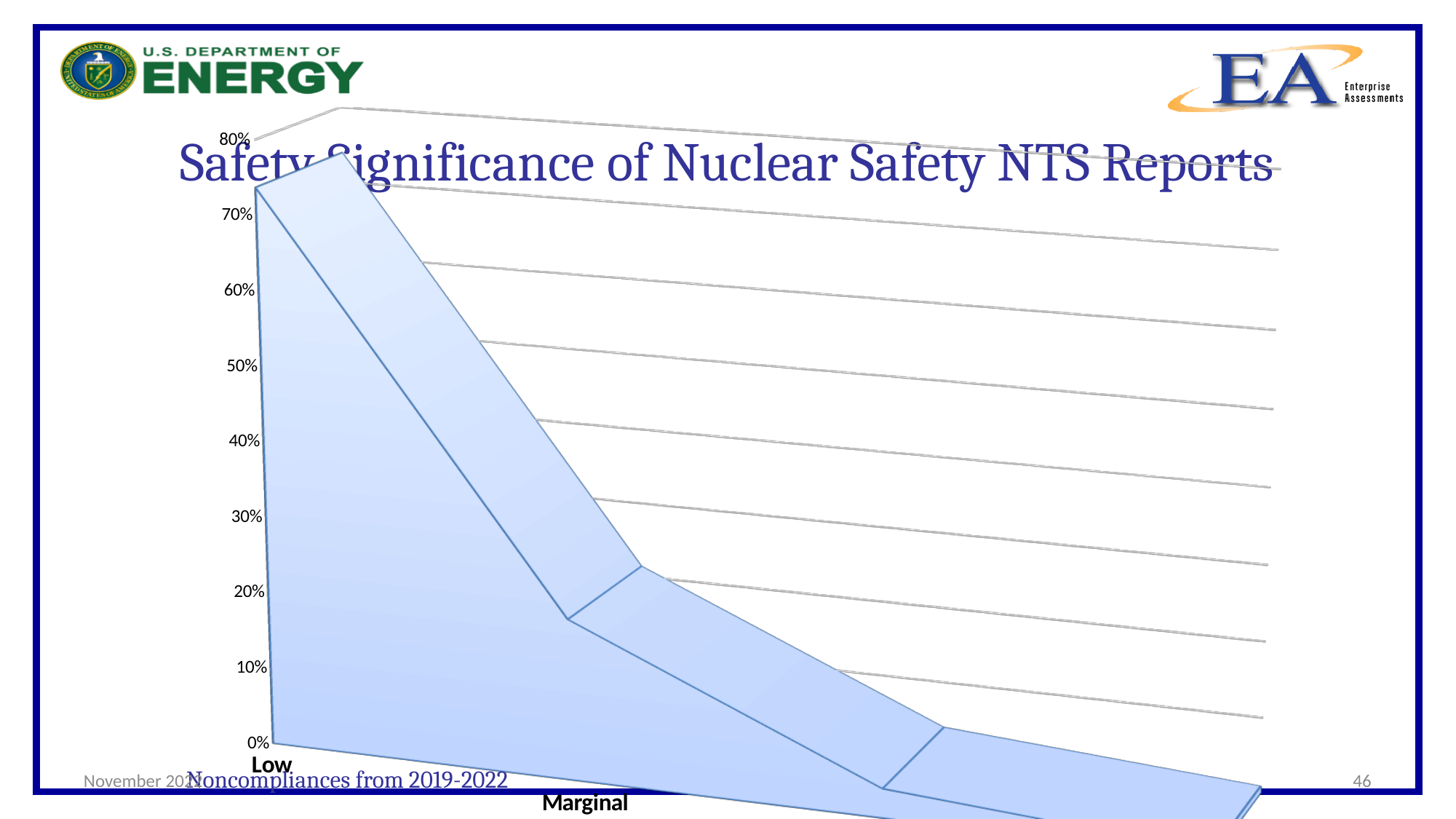
Is the value for Low greater or less than 50%? greater Which category has the highest value, Low or Marginal? Low Do the values rise or fall moving from Low to Marginal along the x axis? fall What is the title of the chart? Safety Significance of Nuclear Safety NTS Reports Is the value for Marginal greater or less than 30%? less What kind of chart is shown on the slide? area chart What is the highest percentage shown on the vertical axis? 80% Which category has the highest value in the chart? Low Is the value for Low greater or less than 60%? greater